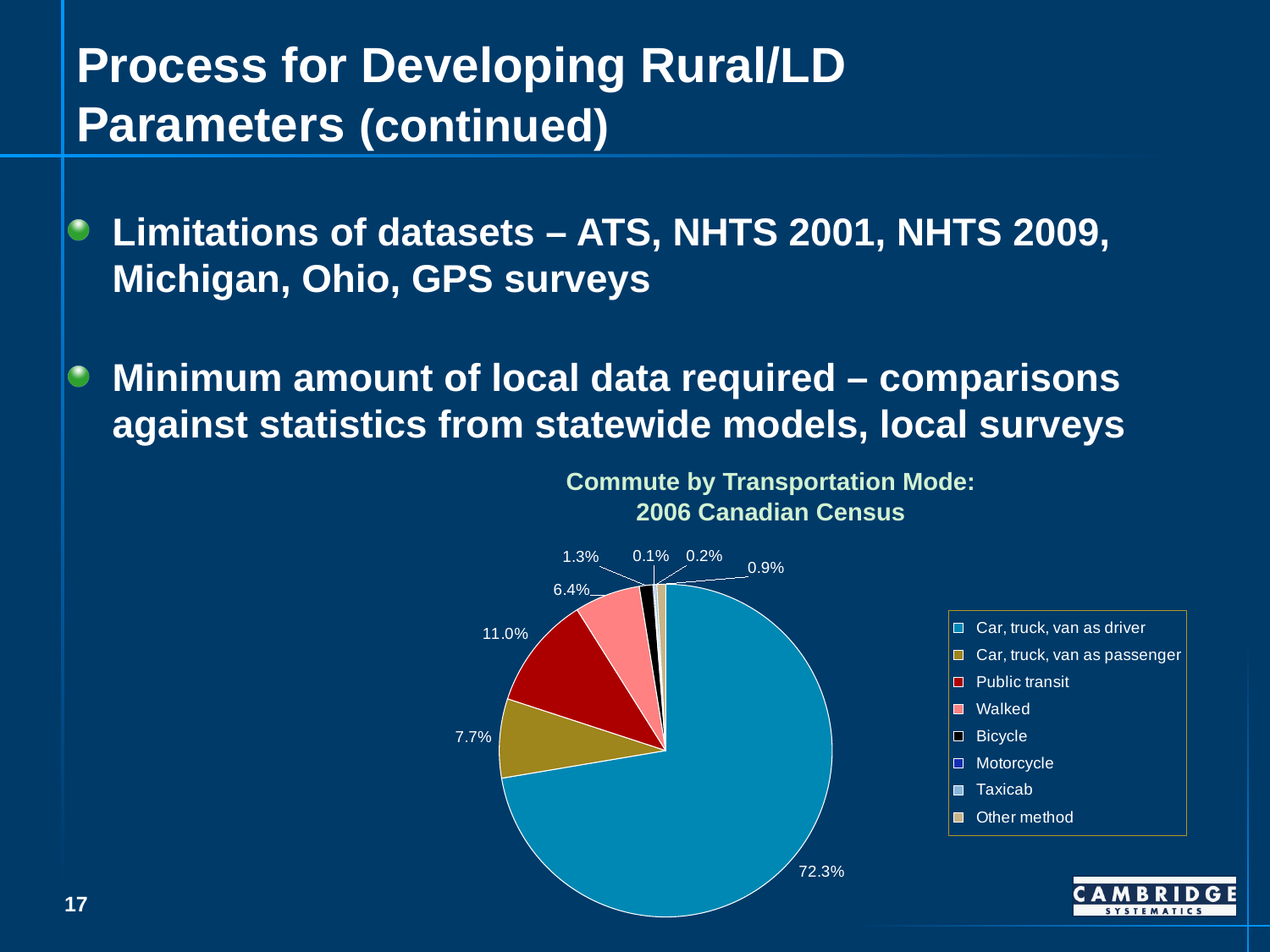
What share of commutes is by car, truck, van as driver? 72.3% What share of commutes is by public transit? 11.0% What is the difference between the public transit share and the car, truck, van as passenger share? 3.3% What kind of chart is shown on the slide? pie chart How many categories does the legend of the pie chart list? 8 Which transportation mode has the largest share of the pie? Car, truck, van as driver What share of commutes is by bicycle? 1.3% Which transportation mode has the smallest share of the pie? Motorcycle What share of commutes is by walking? 6.4% What share of commutes is by car, truck, van as passenger? 7.7% Which has a larger share, public transit or walked? Public transit What is the title of the chart? Commute by Transportation Mode: 2006 Canadian Census